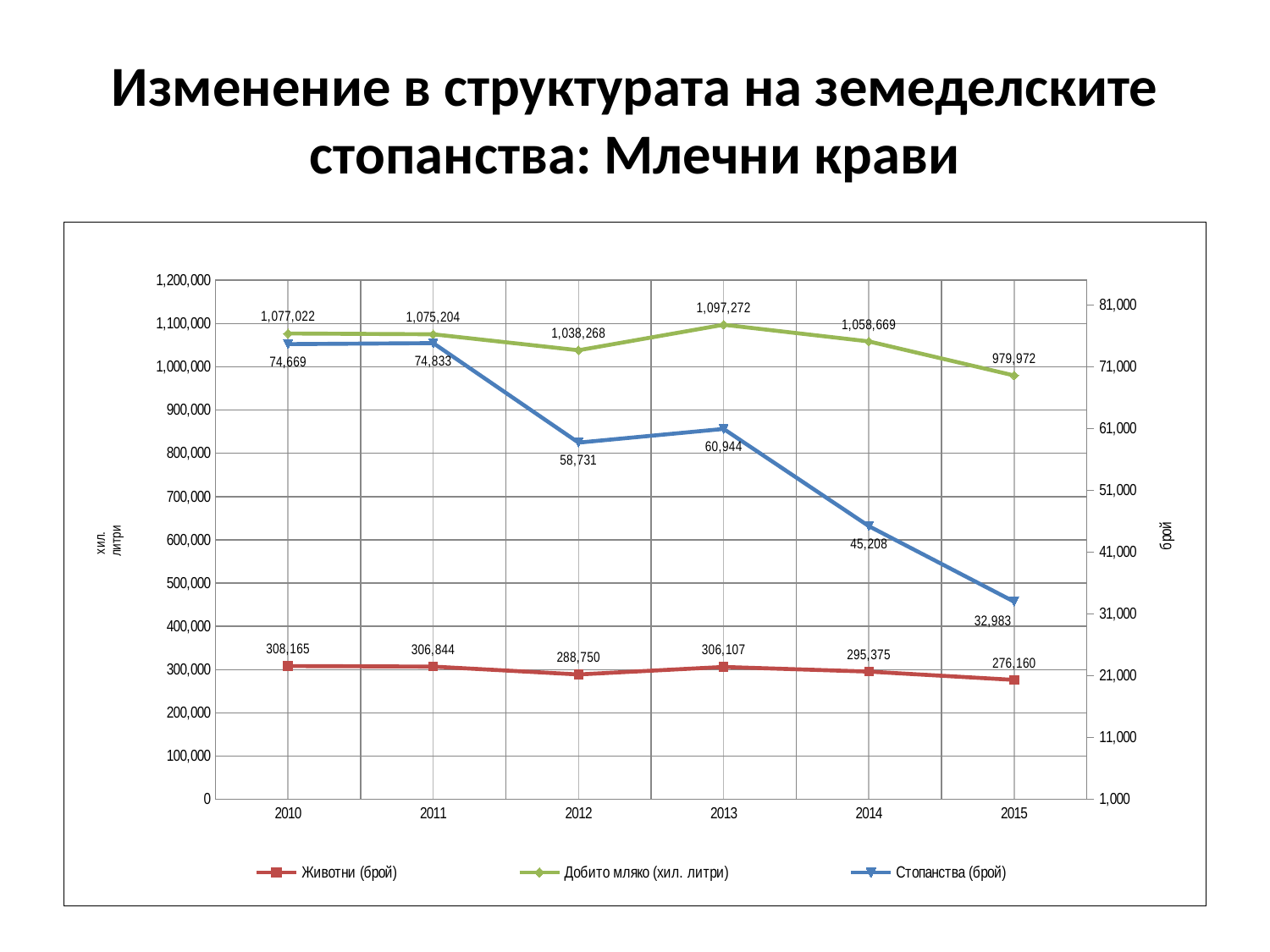
How many series does the legend list? 3 In which year is Добито мляко (хил. литри) highest? 2013 What is the difference between the Стопанства (брой) values for 2010 and 2015? 41,686 What is the value of Стопанства (брой) in 2015? 32,983 What is the title of the slide? Изменение в структурата на земеделските стопанства: Млечни крави How many years are plotted along the x axis? 6 Does the Стопанства (брой) series rise or fall from 2011 to 2015? fall What is the value of Животни (брой) in 2012? 288,750 Which is larger, the Животни (брой) value for 2010 or for 2015? 2010 What is the value of Добито мляко (хил. литри) in 2013? 1,097,272 In which year is Стопанства (брой) lowest? 2015 What kind of chart is shown on the slide? line chart